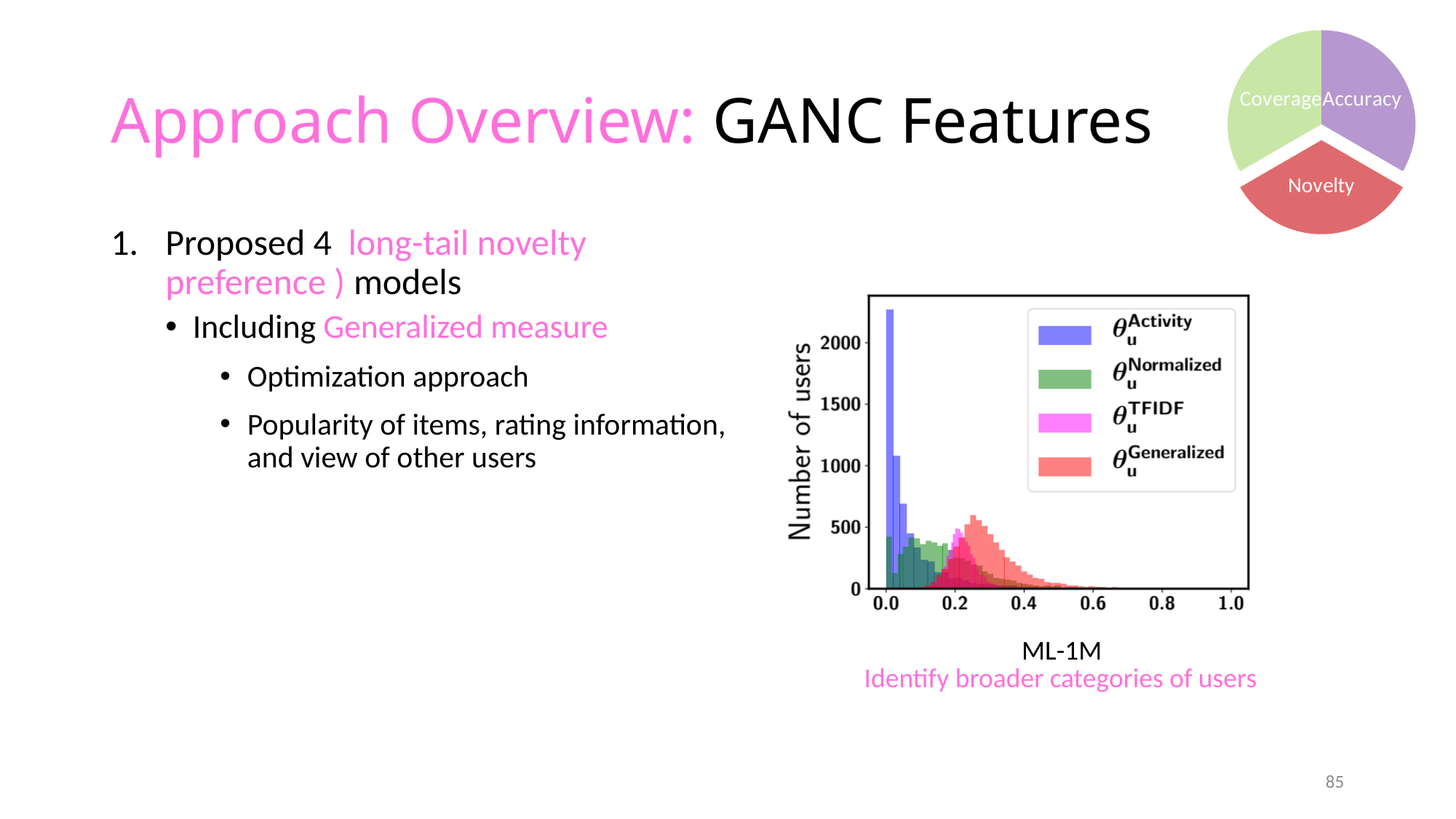
On the ML-1M chart, is the tallest bar of the θ_u^Activity series greater or less than 2000 users? greater What kind of chart is the ML-1M chart in the lower right of the slide? bar chart (histogram) On the ML-1M chart, what is the largest value shown on the x axis? 1.0 On the ML-1M chart, is the tallest bar of the θ_u^Normalized series greater or less than 500 users? less On the ML-1M chart, is the tallest bar of the θ_u^Generalized series greater or less than 1000 users? less On the ML-1M chart, what is the label of the y axis? Number of users On the ML-1M chart, which series reaches the highest number of users in a single bar? θ_u^Activity What kind of chart is shown in the top right corner of the slide? pie chart On the ML-1M chart, which colour represents the θ_u^Generalized series? red On the ML-1M chart, which series has the higher peak, θ_u^Activity or θ_u^Generalized? θ_u^Activity How many slices does the pie chart in the top right corner of the slide have? 3 On the ML-1M histogram chart, how many series does the legend list? 4